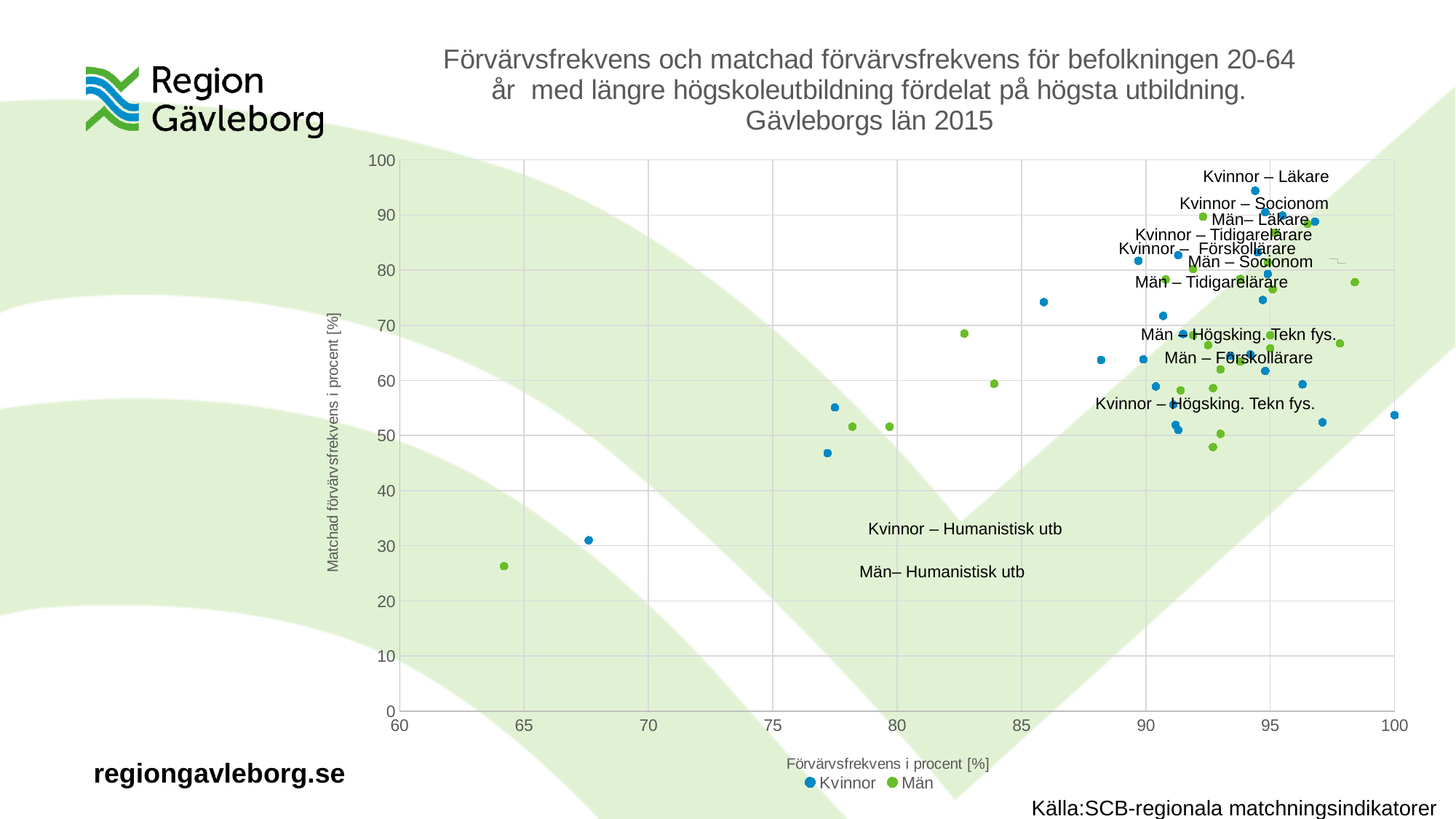
Is the matched employment rate (vertical axis) of the lowest point on the chart greater or less than 30? less Which has the higher matched employment rate (vertical axis): Kvinnor – Läkare or Kvinnor – Socionom? Kvinnor – Läkare What are the two series named in the legend? Kvinnor and Män What is the title of the vertical axis? Matchad förvärvsfrekvens i procent [%] What kind of chart is shown on the slide? Scatter chart Is the matched employment rate (vertical axis) for Kvinnor – Läkare greater or less than 90? greater Do the matched employment rates generally rise or fall as the employment rate on the horizontal axis increases? rise Is the employment rate (horizontal axis) for Kvinnor – Läkare greater or less than 90? greater Is the lowest point on the chart from the Kvinnor series or the Män series? Män How many series does the legend list? 2 Which labelled point has the highest matched employment rate (vertical axis)? Kvinnor – Läkare